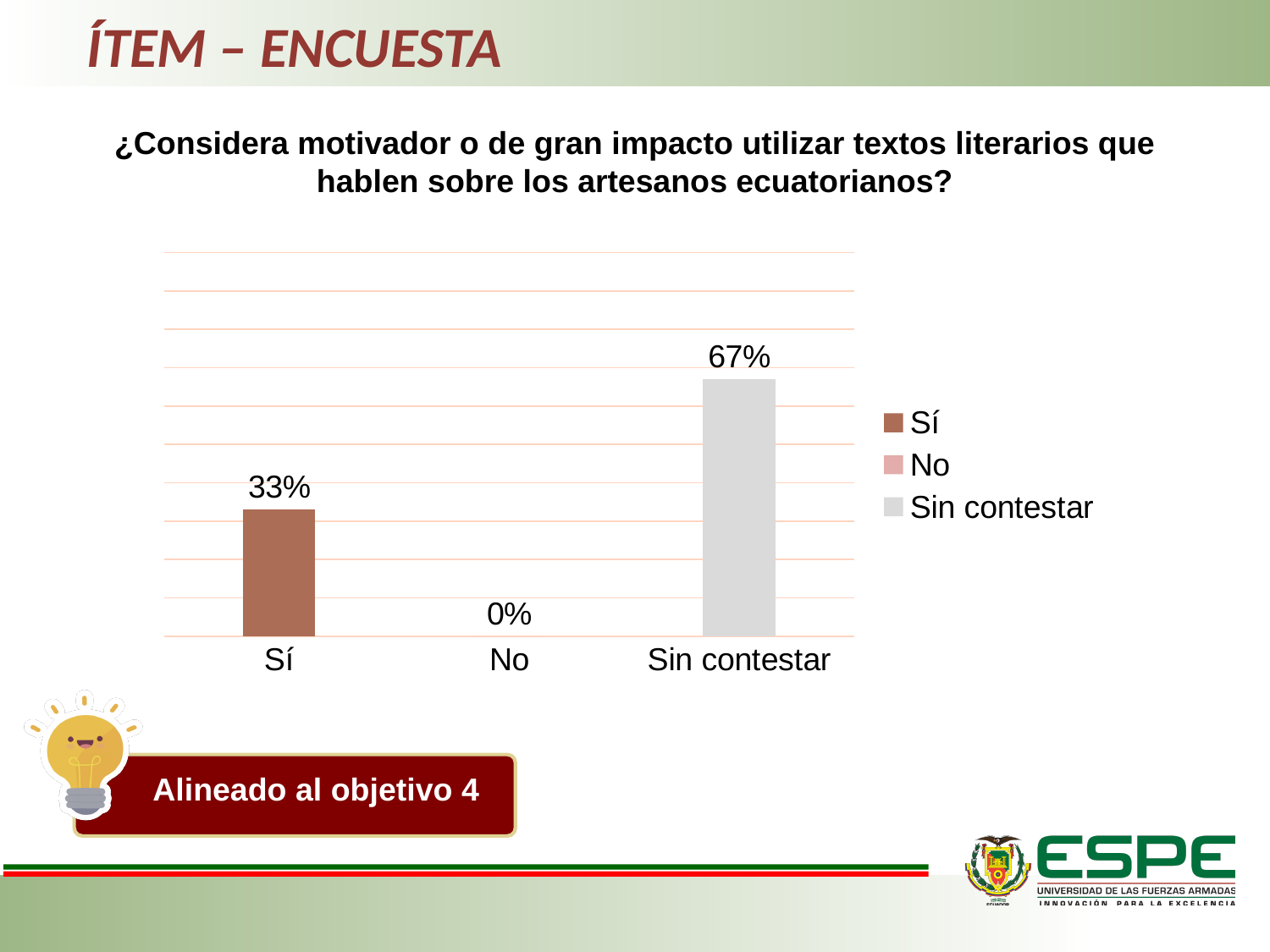
How many categories are shown on the x axis? 3 How many entries does the legend list? 3 What is the total of the values for Sí, No and Sin contestar? 100% What is the value for No? 0% What is the difference between the values for Sin contestar and Sí? 34% What is the value for Sin contestar? 67% What kind of chart is shown on the slide? Bar chart Which legend entry is shown in grey? Sin contestar What is the value for Sí? 33% Which category has the highest value? Sin contestar Which category has the lowest value? No Which is larger, the value for Sí or the value for Sin contestar? Sin contestar